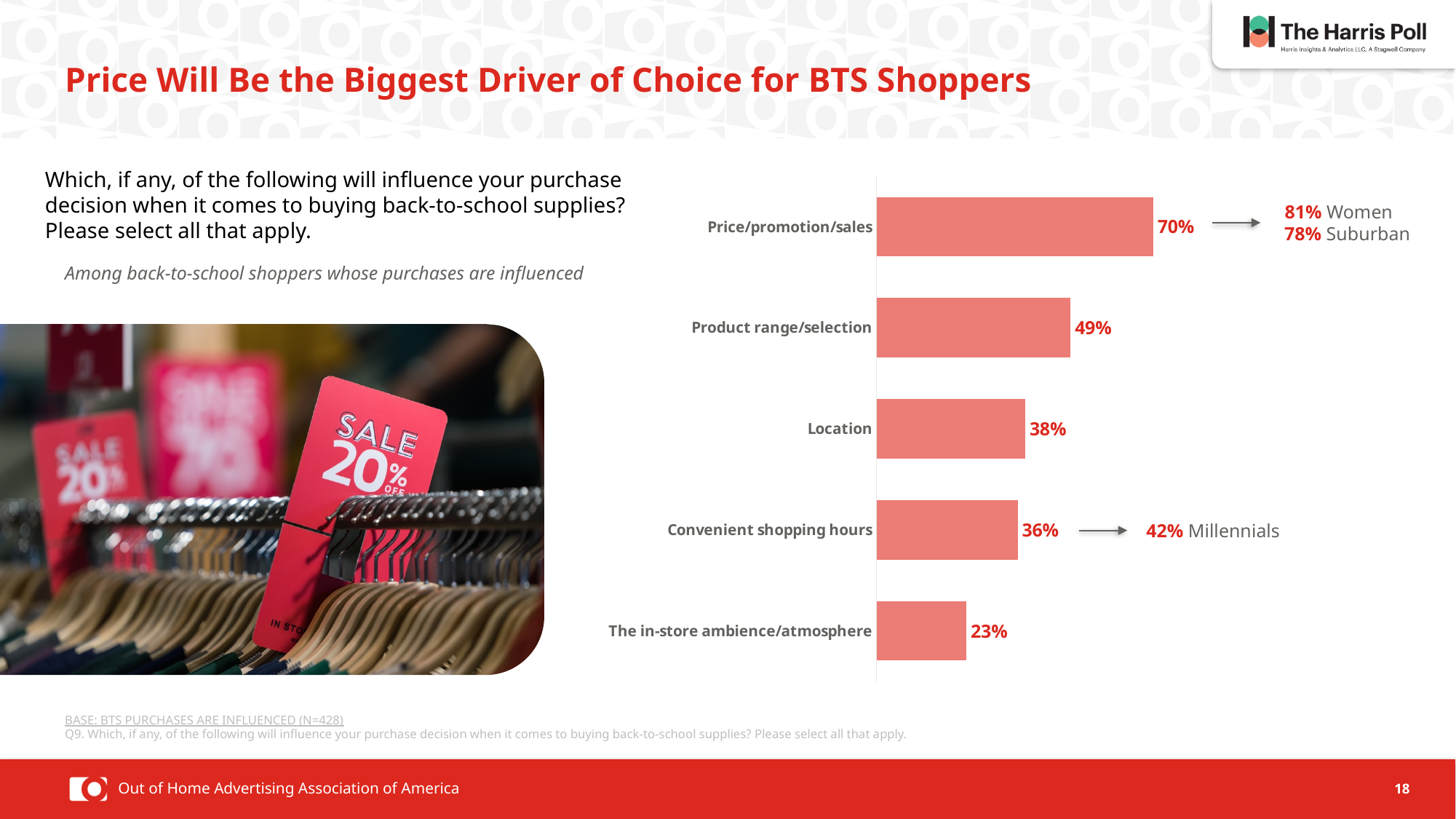
Which factor has the lowest percentage in the chart? The in-store ambience/atmosphere What percentage of back-to-school shoppers say price/promotion/sales will influence their purchase decision? 70% Which is larger, the value for Product range/selection or the value for Location? Product range/selection What kind of chart is shown on the slide? Bar chart How many factors are plotted in the chart? 5 What is the difference in percentage points between Location and Convenient shopping hours? 2 Which factor has the highest percentage in the chart? Price/promotion/sales What is the value shown for Location? 38% What is the difference in percentage points between Price/promotion/sales and Product range/selection? 21 What is the value shown for The in-store ambience/atmosphere? 23% What is the value shown for Product range/selection? 49% What percentage of Millennials is called out next to the Convenient shopping hours bar? 42%